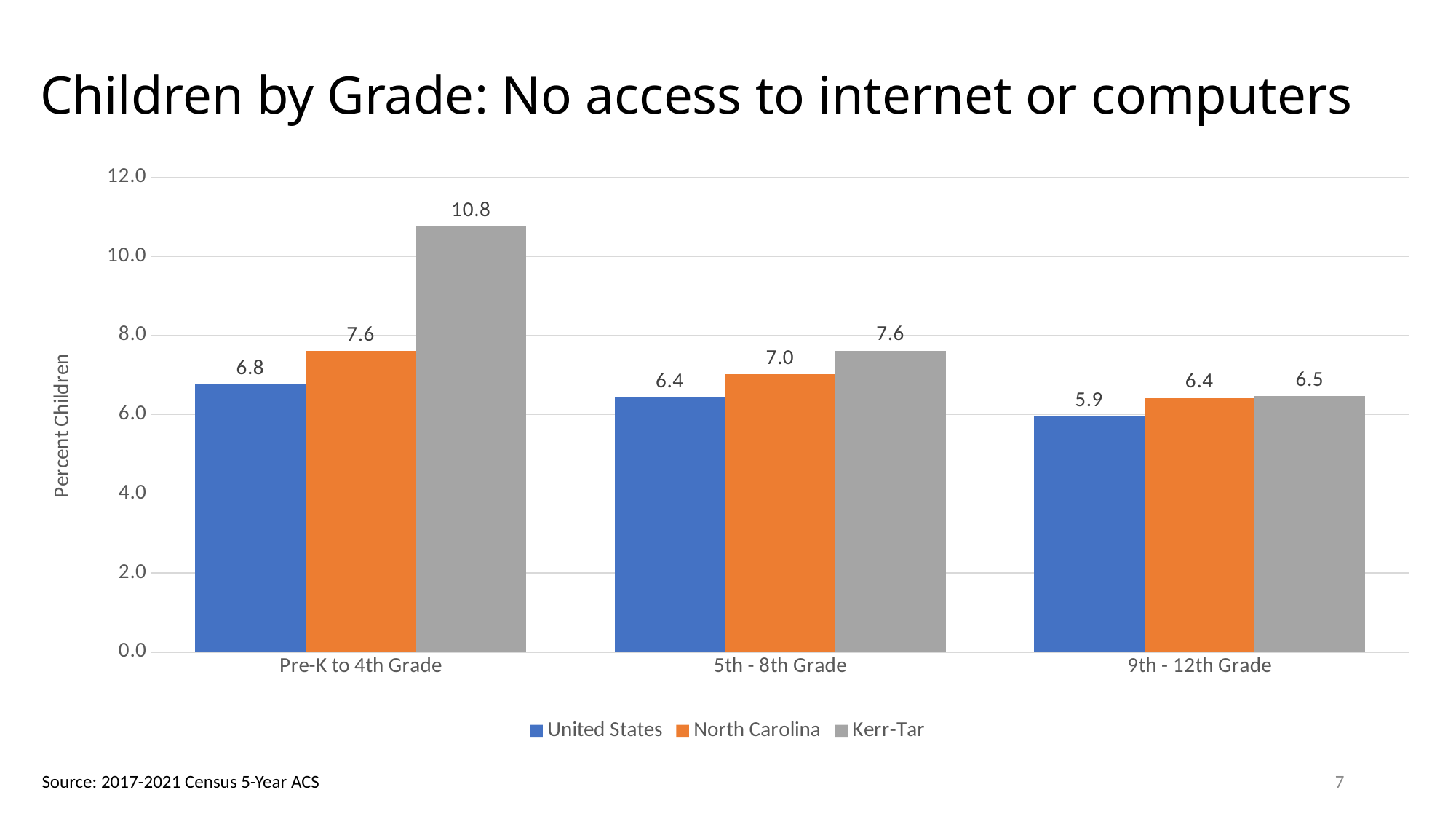
What is the value for Kerr-Tar in the Pre-K to 4th Grade category? 10.8 Is the Kerr-Tar value for Pre-K to 4th Grade greater or less than 10.0? greater Which grade category has the lowest United States value? 9th - 12th Grade Do the United States values rise or fall from Pre-K to 4th Grade to 9th - 12th Grade? Fall How many grade categories are shown on the x axis? 3 Which is larger for 5th - 8th Grade: the North Carolina value or the Kerr-Tar value? Kerr-Tar Which grade category has the highest Kerr-Tar value? Pre-K to 4th Grade What is the difference between the Kerr-Tar and United States values for Pre-K to 4th Grade? 4.0 What is the value for United States in the 9th - 12th Grade category? 5.9 What is the value for North Carolina in the 5th - 8th Grade category? 7.0 How many series does the legend list? 3 What kind of chart is shown on the slide? Bar chart